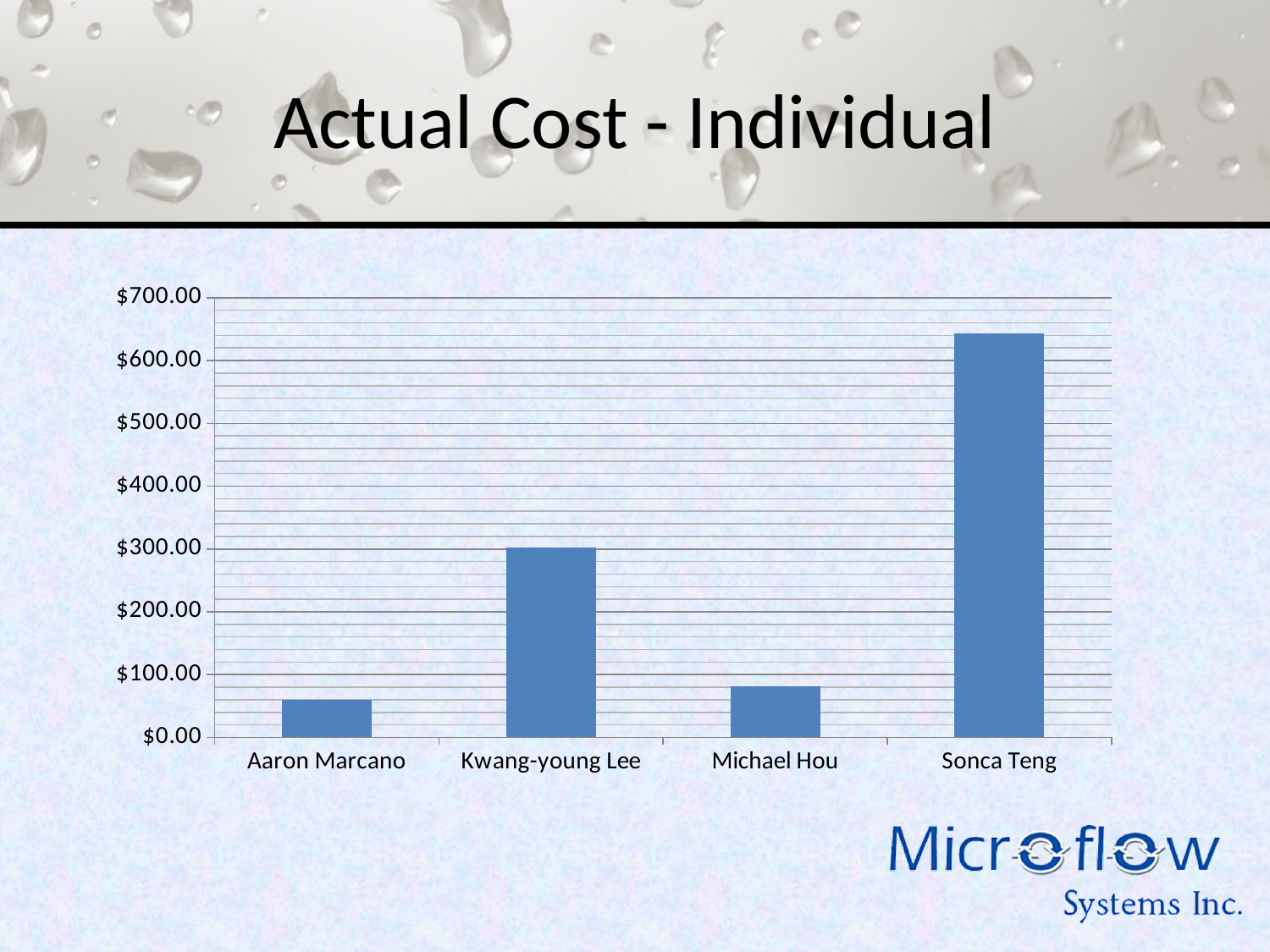
Is the value for Sonca Teng greater or less than $700.00? less Which individual has the lowest actual cost? Aaron Marcano How many individuals are shown on the x axis of the chart? 4 Is the value for Michael Hou greater or less than $100.00? less What type of chart is shown on the slide? bar chart Is the value for Aaron Marcano greater or less than $100.00? less Which is larger, the actual cost for Kwang-young Lee or for Michael Hou? Kwang-young Lee Which individual has the highest actual cost? Sonca Teng Which is larger, the actual cost for Michael Hou or for Aaron Marcano? Michael Hou What is the title of the slide's chart? Actual Cost - Individual